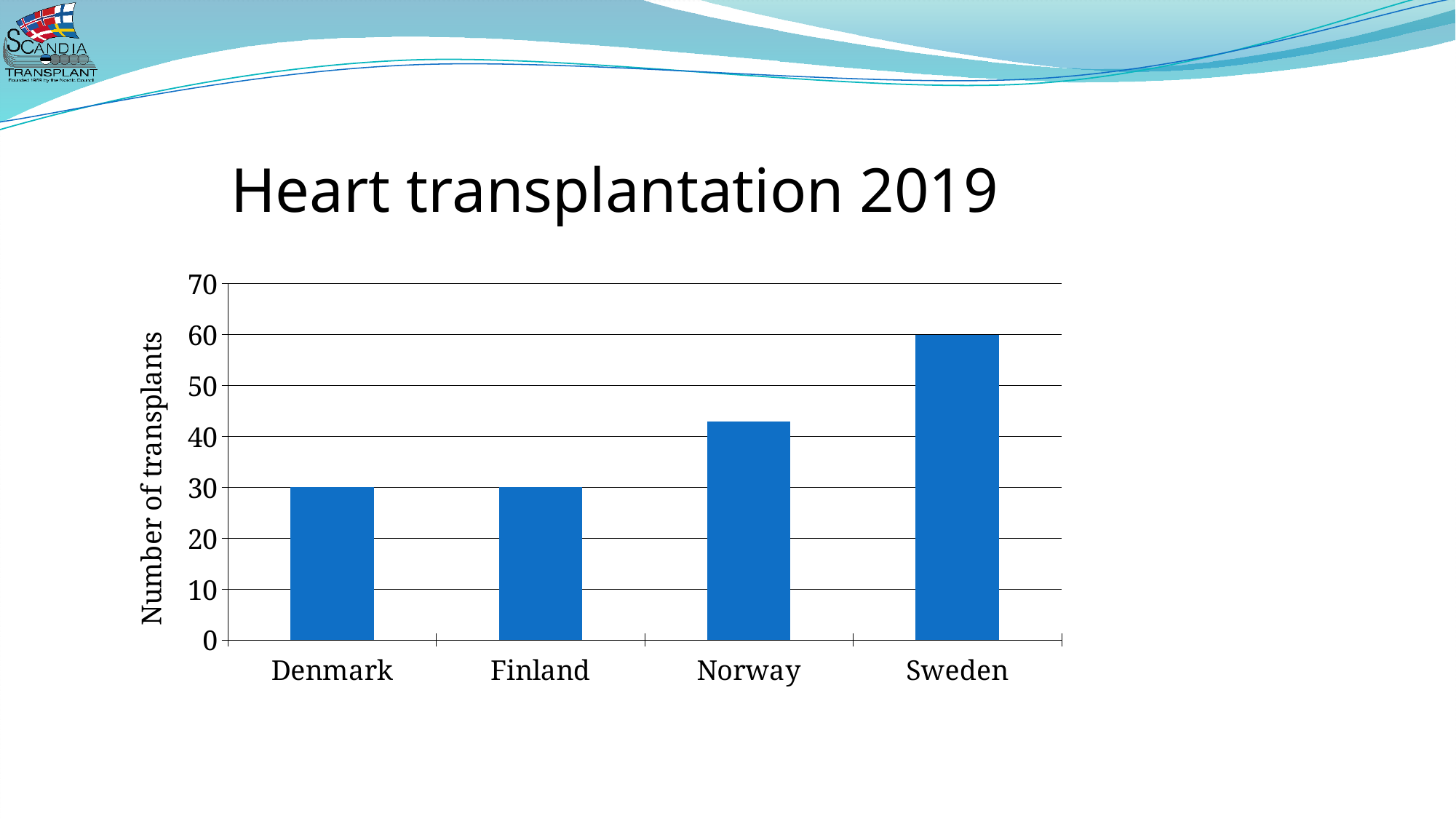
What is the label on the vertical axis of the chart? Number of transplants What is the number of heart transplants shown for Denmark? 30 How many countries are shown on the x axis of the chart? 4 What is the difference between the values for Sweden and Denmark? 30 Do the values generally rise or fall from Denmark to Sweden along the x axis? Rise What is the number of heart transplants shown for Finland? 30 Is the value for Norway greater or less than 40? greater Is the value for Norway greater or less than 50? less Which country has the highest number of heart transplants in the chart? Sweden Which has a larger value, Sweden or Norway? Sweden What kind of chart is shown on the slide? Bar chart What is the number of heart transplants shown for Sweden? 60